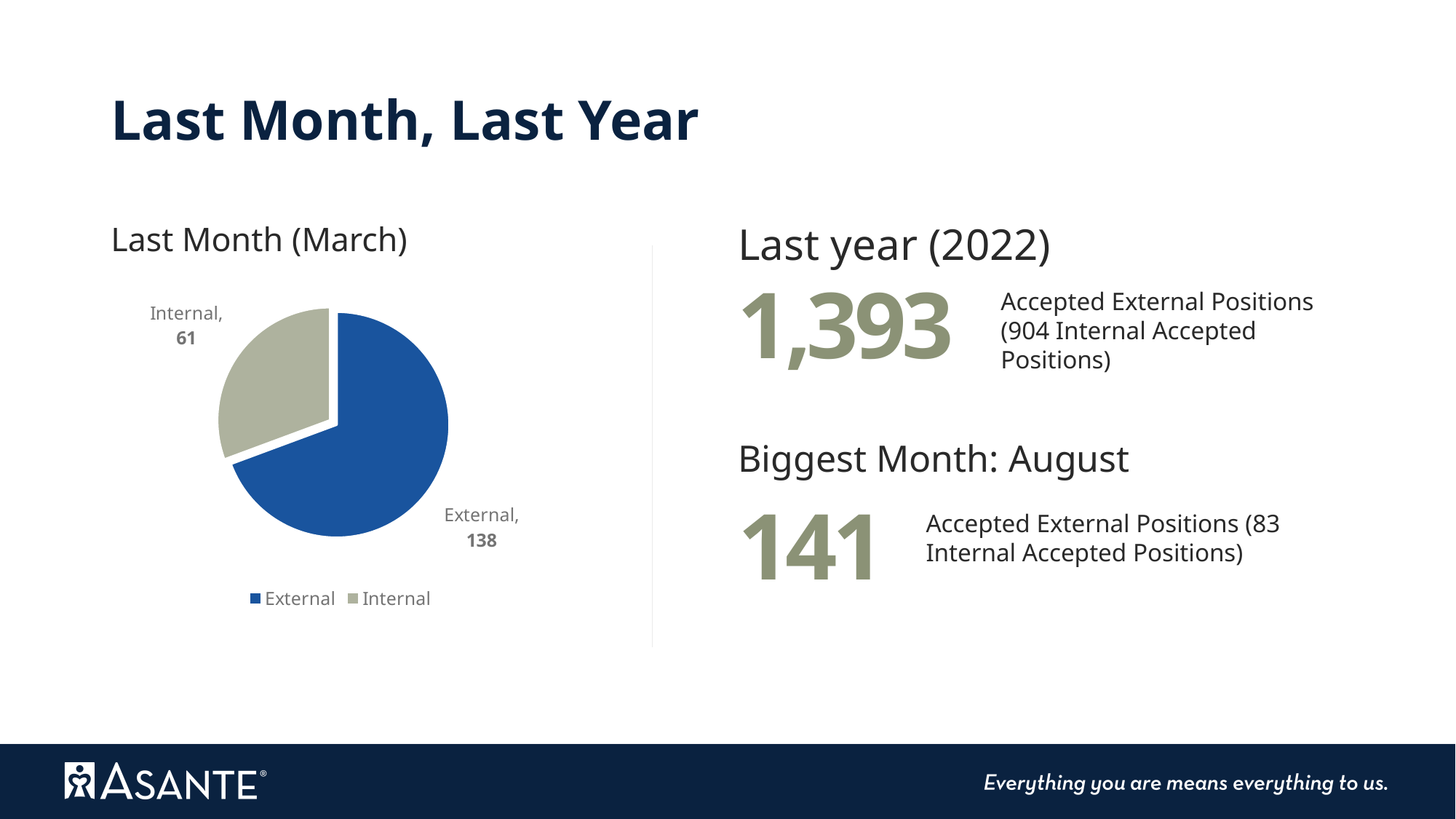
In the "Last Month (March)" pie chart, what is the difference between the External and Internal values? 77 In the "Last Month (March)" pie chart, what is the value for External? 138 In the "Last Month (March)" pie chart, what is the value for Internal? 61 In the "Last Month (March)" pie chart, which category has the largest slice? External In the "Last Month (March)" pie chart, what colour is the External slice? blue In the "Last Month (March)" pie chart, which category has the smallest slice? Internal What is the total of the two slices in the "Last Month (March)" pie chart? 199 What type of chart is shown under "Last Month (March)"? pie chart In the "Last Month (March)" pie chart, is the External value larger or smaller than the Internal value? larger How many entries does the legend of the "Last Month (March)" pie chart list? 2 In the "Last Month (March)" pie chart, what share of the total does the External slice represent, to the nearest whole percent? 69% How many slices does the "Last Month (March)" pie chart have? 2